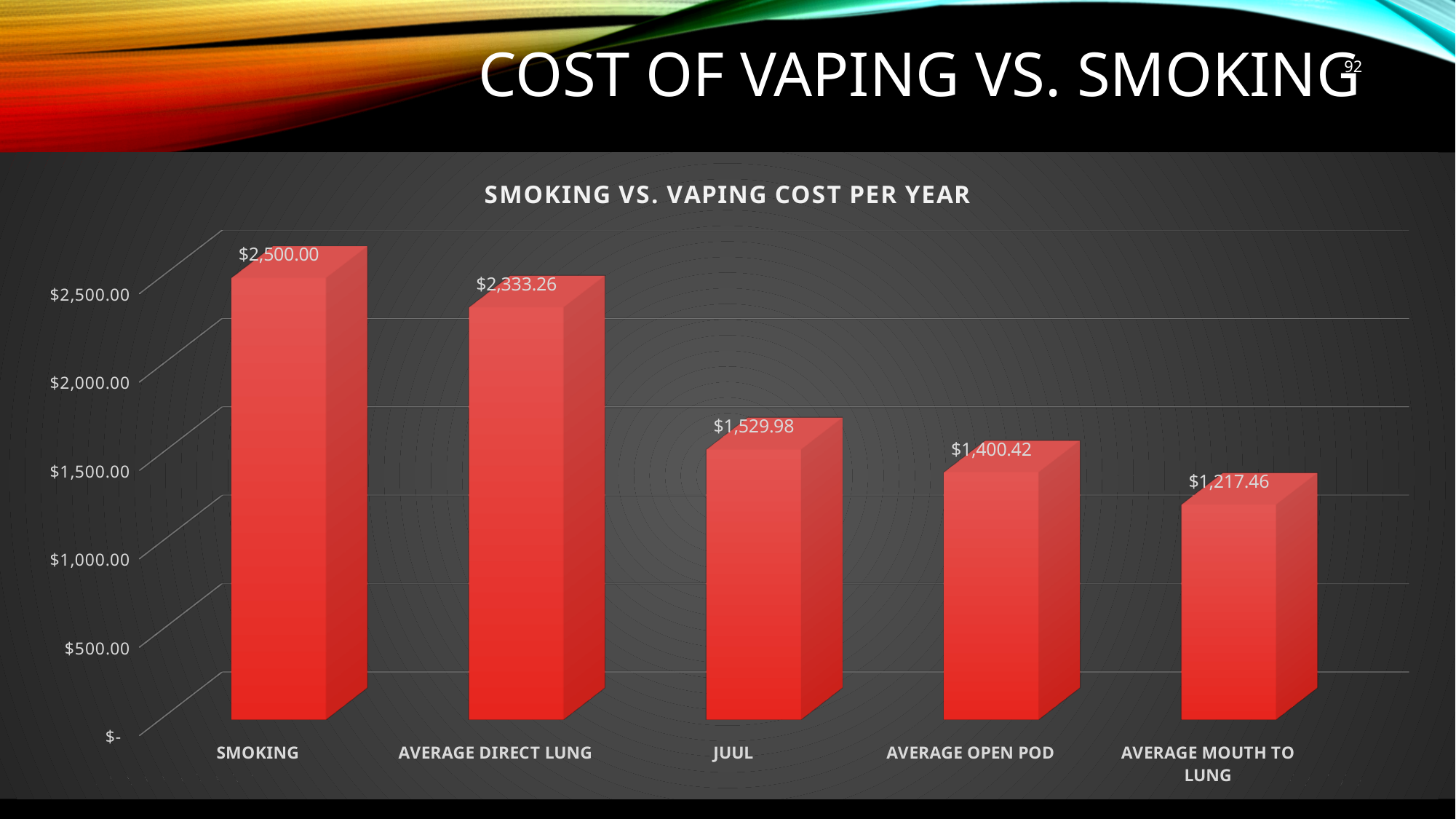
What is the cost per year for Smoking? $2,500.00 What is the difference in cost per year between Smoking and Average Direct Lung? $166.74 What is the cost per year for Average Mouth to Lung? $1,217.46 What is the cost per year for JUUL? $1,529.98 Which category has the highest cost per year? Smoking How many categories are shown in the chart? 5 Which has a higher cost per year, JUUL or Average Open Pod? JUUL What kind of chart is shown on the slide? Bar chart What is the cost per year for Average Direct Lung? $2,333.26 What is the difference in cost per year between JUUL and Average Open Pod? $129.56 What is the title of the chart? Smoking vs. Vaping Cost Per Year Which category has the lowest cost per year? Average Mouth to Lung